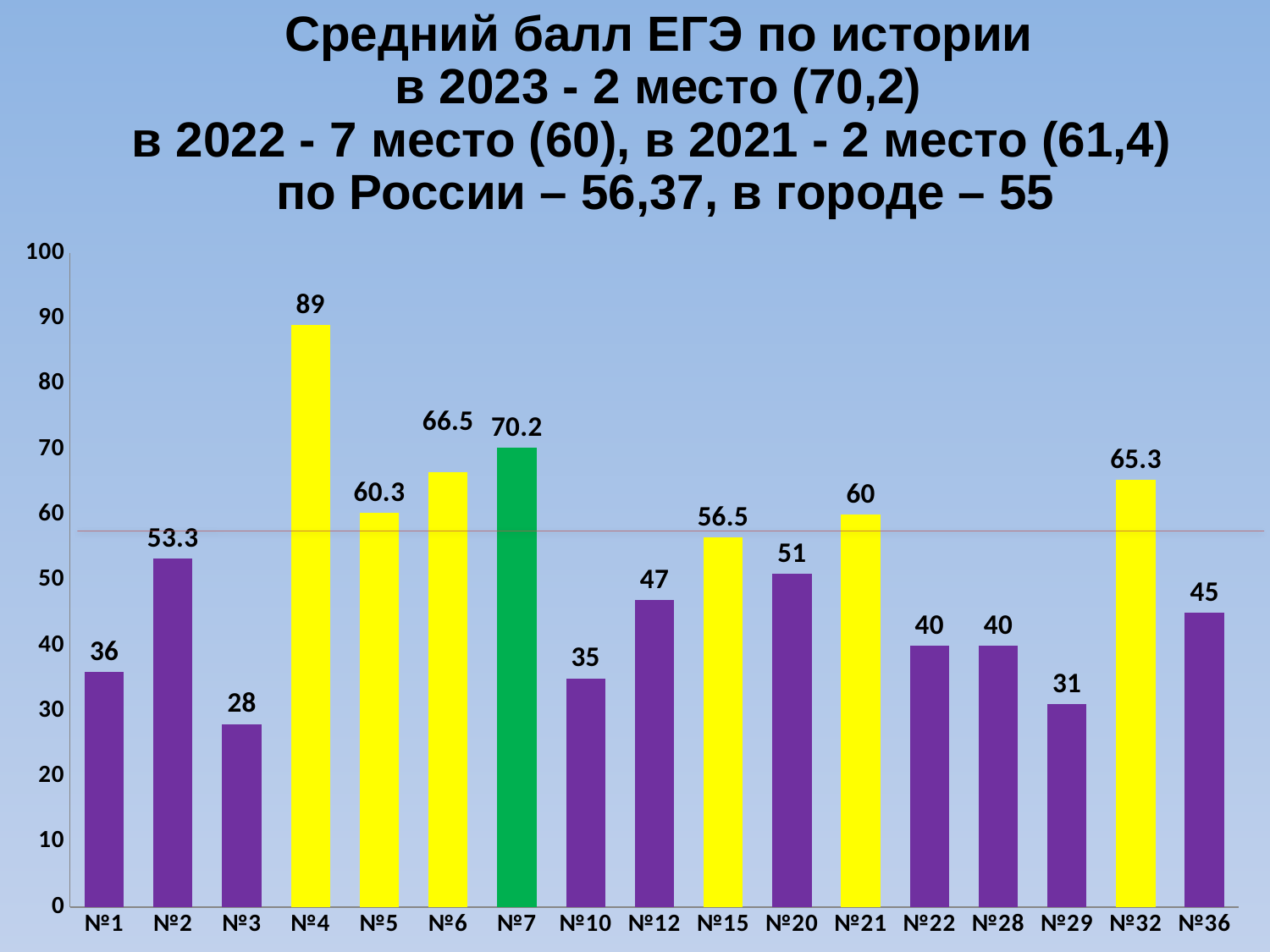
What is the difference between the values for №7 and №21? 10.2 Is the value for №15 greater or less than 50? greater How many categories are shown on the x axis? 17 Which category has the lowest value? №3 Which is larger, the value for №2 or the value for №20? №2 What colour is the bar for №7? green What kind of chart is shown on the slide? bar chart What is the difference between the values for №4 and №3? 61 What is the value for №32? 65.3 What is the value for №4? 89 What is the value for №7? 70.2 Which category has the highest value? №4